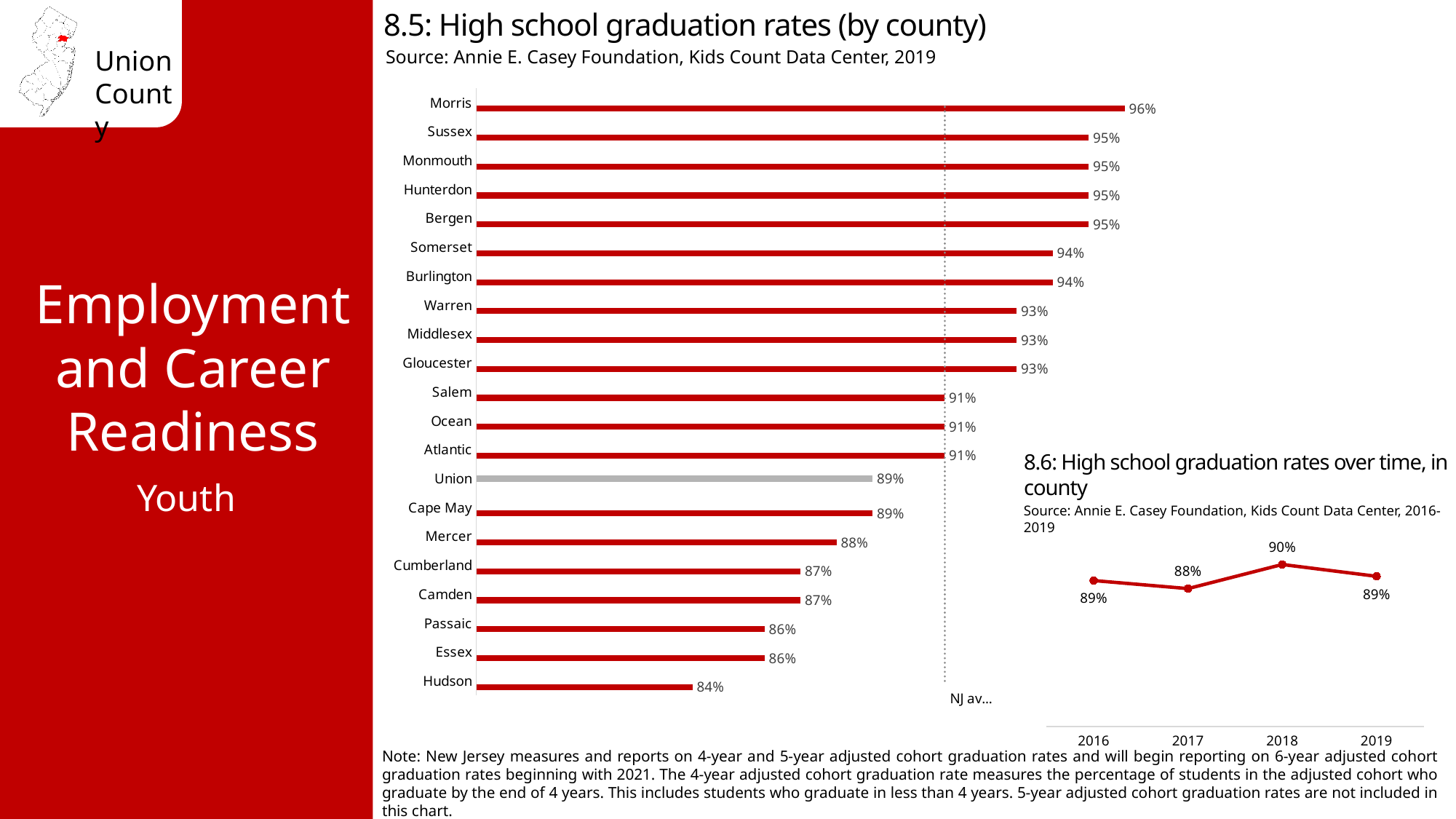
In the chart '8.5: High school graduation rates (by county)', what is the difference between the graduation rates of Morris and Hudson? 12% In the chart '8.5: High school graduation rates (by county)', which county has the highest graduation rate? Morris In the chart '8.6: High school graduation rates over time, in county', which year had the lowest graduation rate? 2017 What kind of chart is '8.5: High school graduation rates (by county)'? Bar chart In the chart '8.5: High school graduation rates (by county)', how many counties are shown? 21 In the chart '8.5: High school graduation rates (by county)', what is the graduation rate for Union? 89% In the chart '8.5: High school graduation rates (by county)', which has a higher graduation rate, Mercer or Passaic? Mercer In the chart '8.5: High school graduation rates (by county)', what is the graduation rate for Somerset? 94% What kind of chart is '8.6: High school graduation rates over time, in county'? Line chart In the chart '8.5: High school graduation rates (by county)', which county has the lowest graduation rate? Hudson In the chart '8.6: High school graduation rates over time, in county', what was the graduation rate in 2018? 90% In the chart '8.6: High school graduation rates over time, in county', how many years are plotted? 4